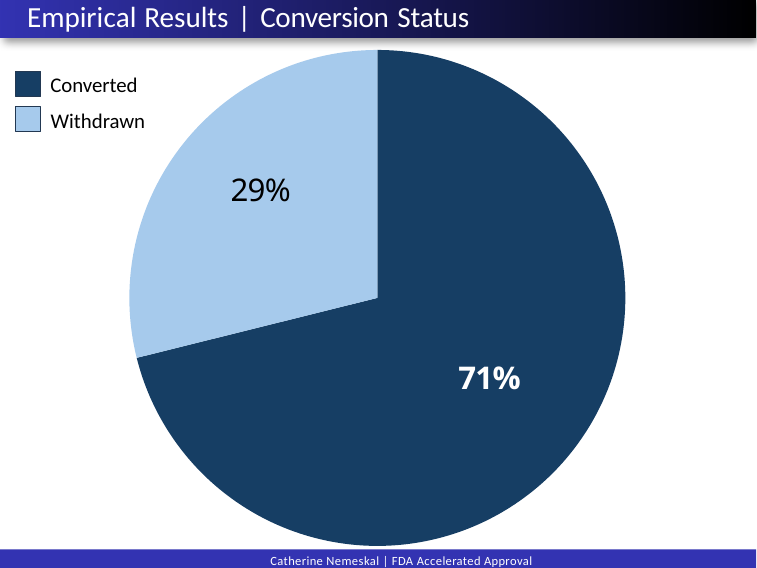
Which is larger, the Converted slice or the Withdrawn slice? Converted What is the difference in percentage points between the Converted and Withdrawn slices? 42 What share of the pie is labelled Converted? 71% Which category has the largest slice of the pie? Converted Which legend entry is shown in the lighter blue colour? Withdrawn How many entries does the legend list? 2 What kind of chart is shown on the slide? pie chart What is the title of the slide containing the chart? Empirical Results | Conversion Status How many slices does the pie chart have? 2 Which category has the smallest slice of the pie? Withdrawn What share of the pie is labelled Withdrawn? 29%